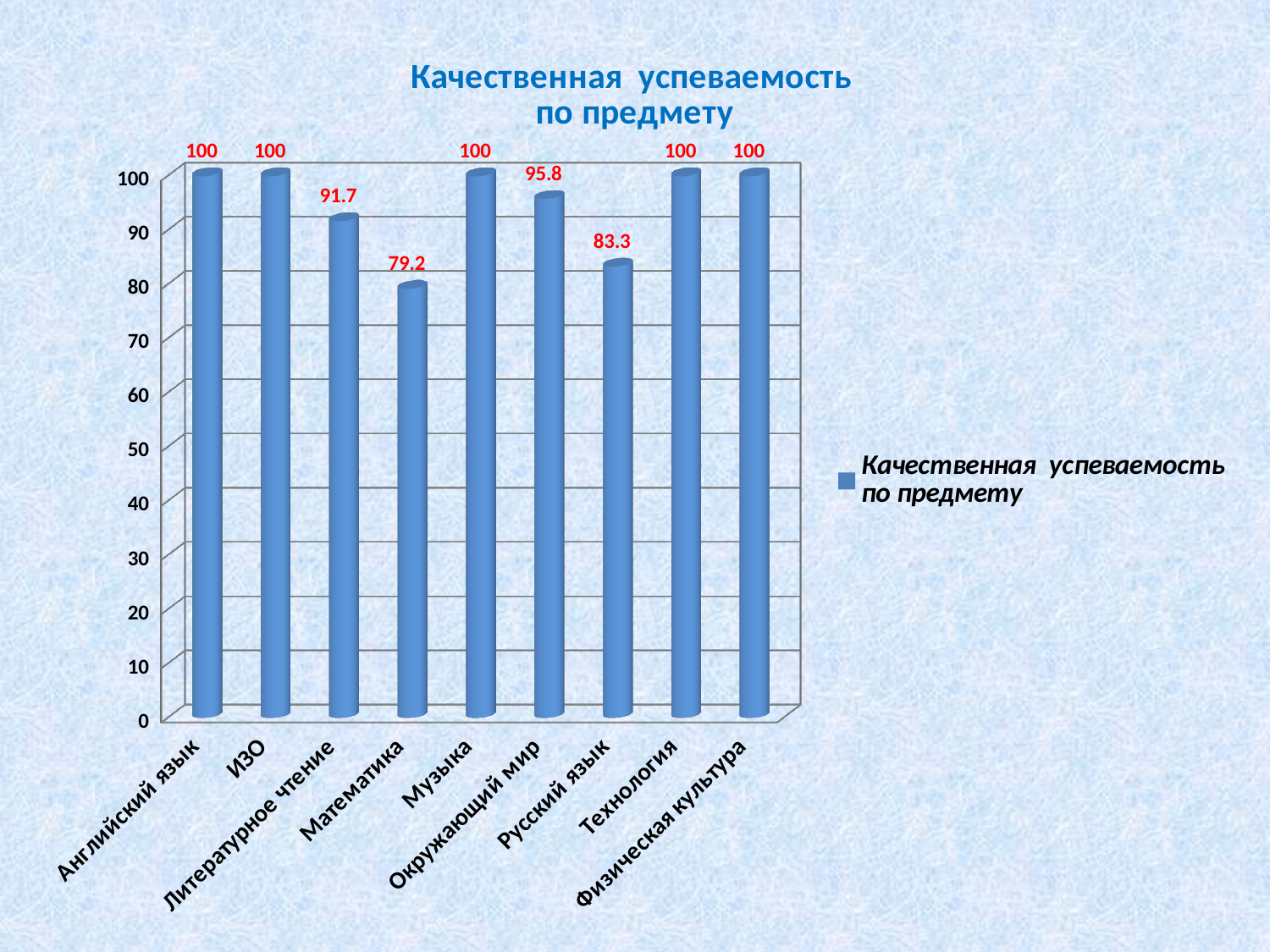
Is the value for Математика greater or less than 80? less What is the value for Математика? 79.2 What is the value for Окружающий мир? 95.8 What is the difference between the values for Окружающий мир and Математика? 16.6 What is the value for Литературное чтение? 91.7 What is the value for Русский язык? 83.3 How many categories are shown on the x axis? 9 Which category has the lowest value? Математика What kind of chart is shown on the slide? bar chart Which is larger, the value for Литературное чтение or the value for Русский язык? Литературное чтение How many categories have a value of 100? 5 What is the difference between the values for Литературное чтение and Русский язык? 8.4